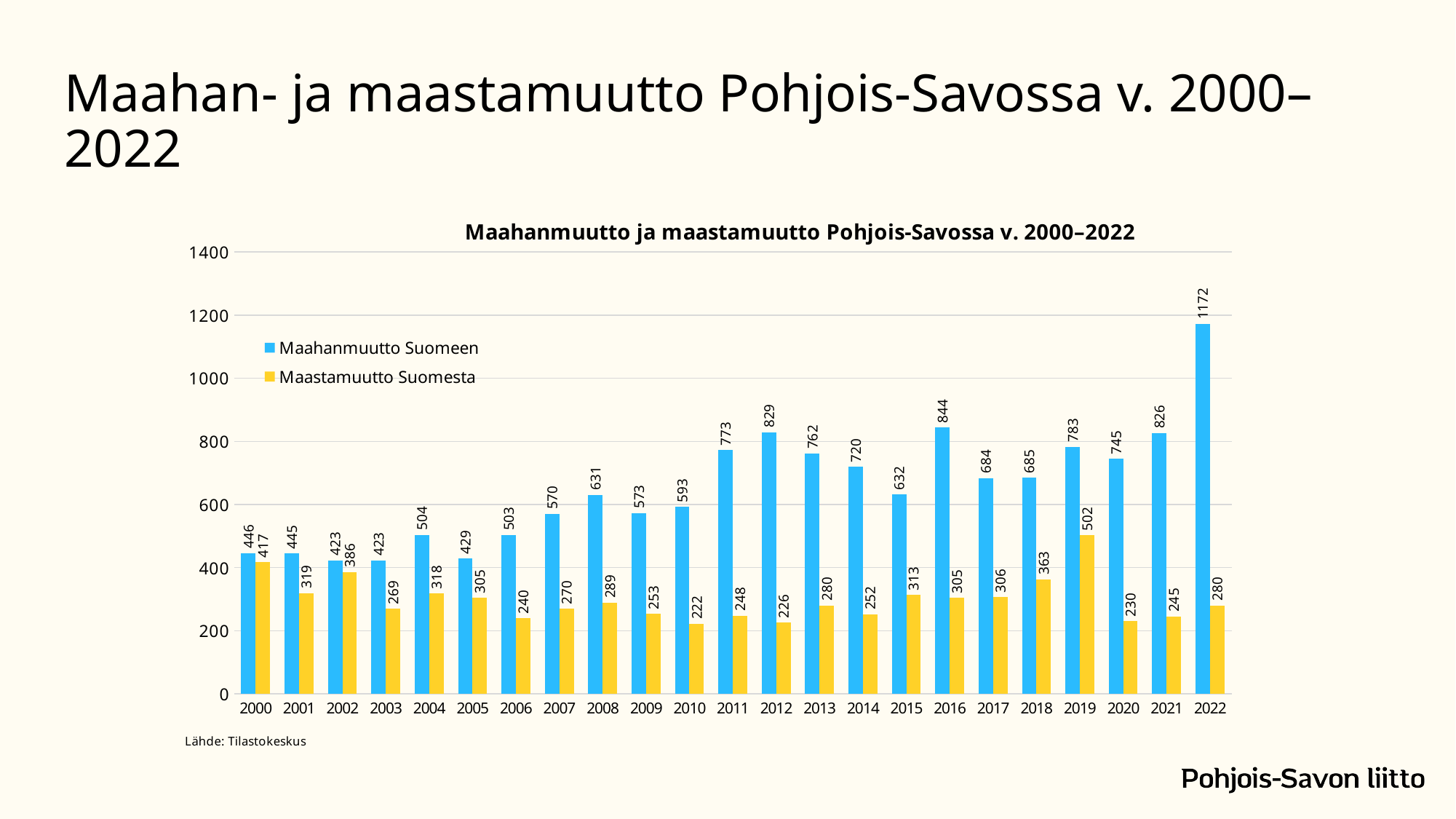
In which year is Maahanmuutto Suomeen highest? 2022 Which year has the larger Maahanmuutto Suomeen value, 2011 or 2015? 2011 How many series does the legend list? 2 What is the difference between Maahanmuutto Suomeen and Maastamuutto Suomesta in 2012? 603 What is the source given below the chart? Tilastokeskus What is the value of Maahanmuutto Suomeen in 2022? 1172 In which year is Maastamuutto Suomesta highest? 2019 What is the difference between Maahanmuutto Suomeen and Maastamuutto Suomesta in 2022? 892 What kind of chart is shown on the slide? Bar chart What is the value of Maastamuutto Suomesta in 2019? 502 In which year is Maastamuutto Suomesta lowest? 2010 How many years are shown on the x axis? 23